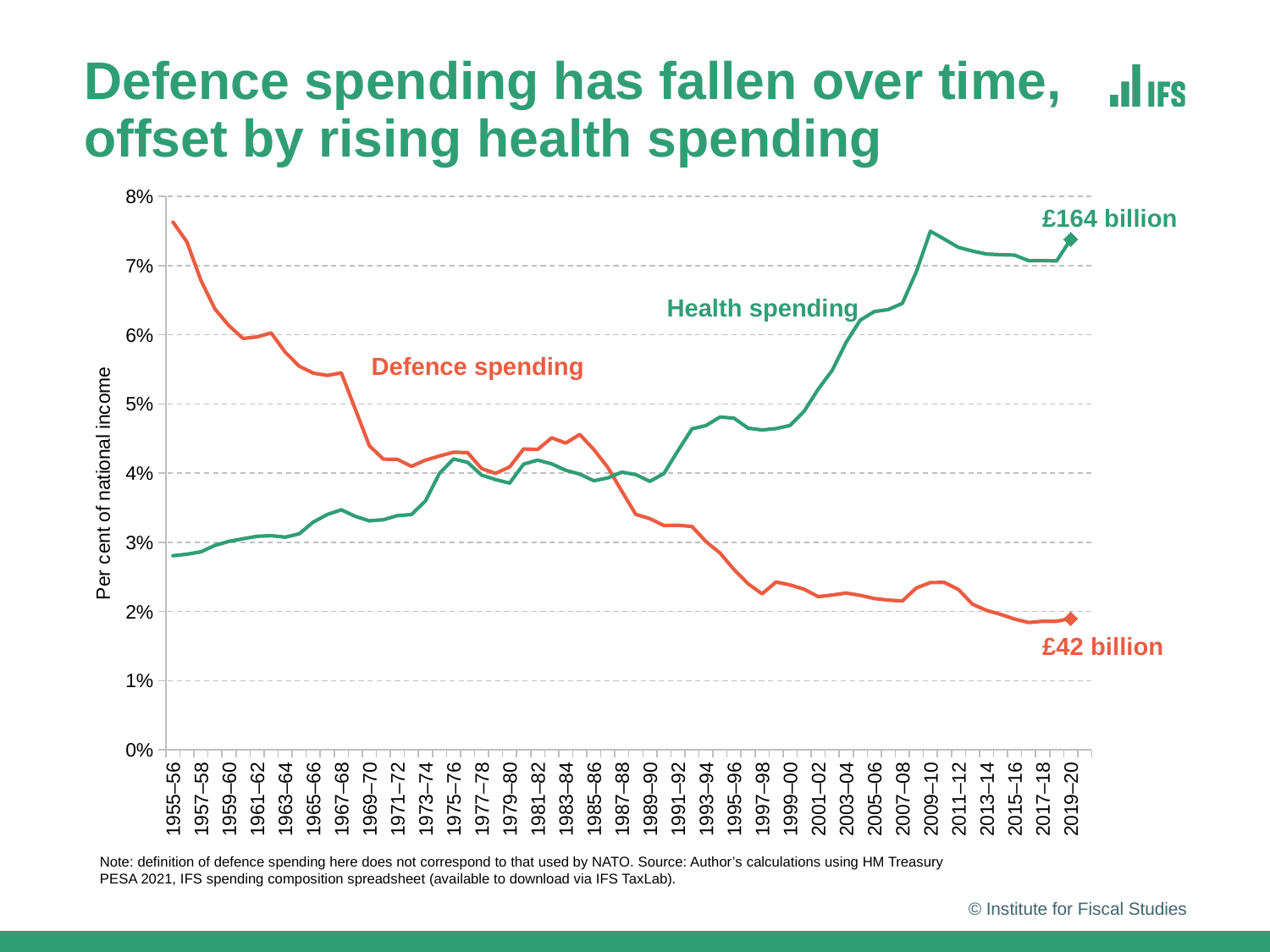
Does Health spending as a per cent of national income rise or fall over the period shown? rise Does Defence spending as a per cent of national income rise or fall over the period shown? fall In 1955–56, which is higher: Defence spending or Health spending? Defence spending How many data series are plotted on the chart? 2 Is the value for Defence spending in 1955–56 greater or less than 7%? greater Is the value for Defence spending in 2019–20 greater or less than 2%? less In 2019–20, which is higher: Defence spending or Health spending? Health spending What kind of chart is shown on the slide? line chart What value is labelled at the end of the Health spending line in 2019–20? £164 billion Is the value for Health spending in 2019–20 greater or less than 7%? greater What value is labelled at the end of the Defence spending line in 2019–20? £42 billion What is the label on the vertical axis of the chart? Per cent of national income